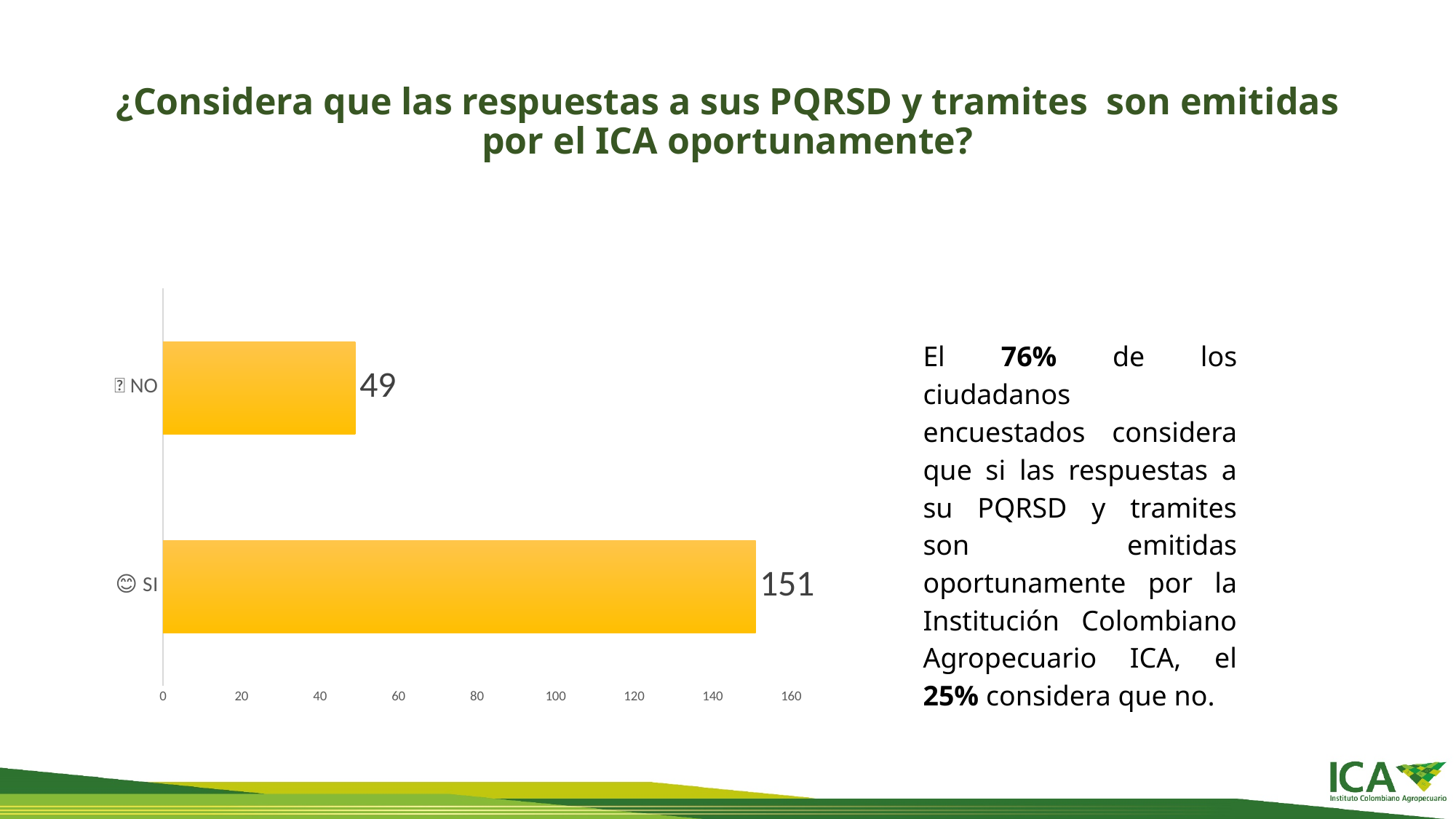
Which category has the highest value? SI Is the value for SI greater or less than 140? greater What is the value for SI? 151 What is the difference between the values for SI and NO? 102 Which is larger, the value for SI or the value for NO? SI Is the value for NO greater or less than 60? less What is the highest tick value shown on the horizontal axis? 160 Which category has the lowest value? NO What is the value for NO? 49 What colour are the bars in the chart? yellow What kind of chart is shown on the slide? bar chart How many categories are shown in the chart? 2